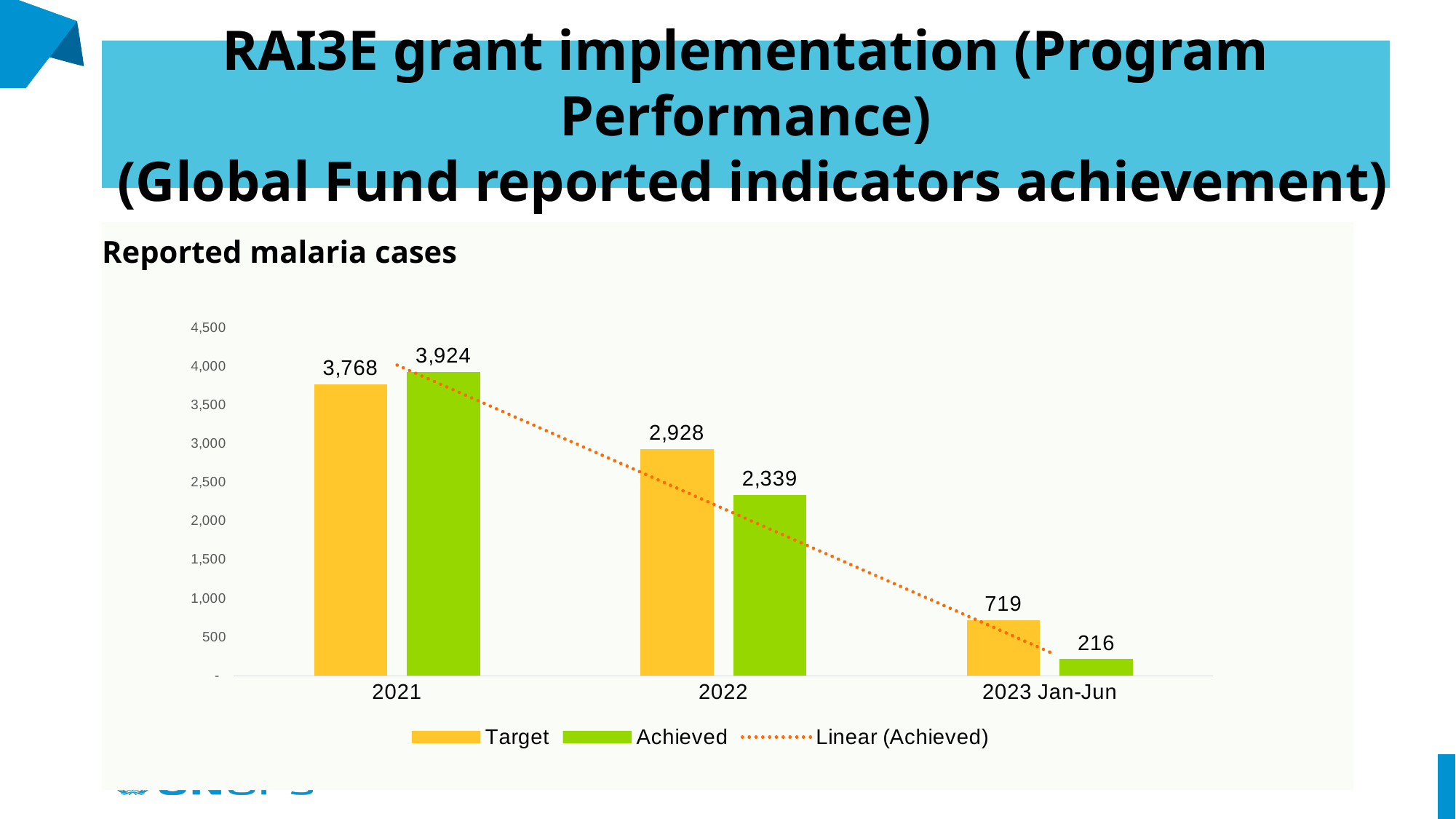
For 2021, which is larger: the Target or the Achieved value? Achieved How many categories are shown on the x axis? 3 What is the Target value for 2021? 3,768 How many entries does the legend list? 3 Is the Target value for 2023 Jan-Jun greater or less than 1,000? less What is the difference between the Target and Achieved values for 2022? 589 Do the Achieved values rise or fall from 2021 to 2023 Jan-Jun? fall What is the Achieved value for 2022? 2,339 What is the Achieved value for 2023 Jan-Jun? 216 Which category has the highest Achieved value? 2021 Which category has the lowest Target value? 2023 Jan-Jun What kind of chart is shown on the slide? bar chart